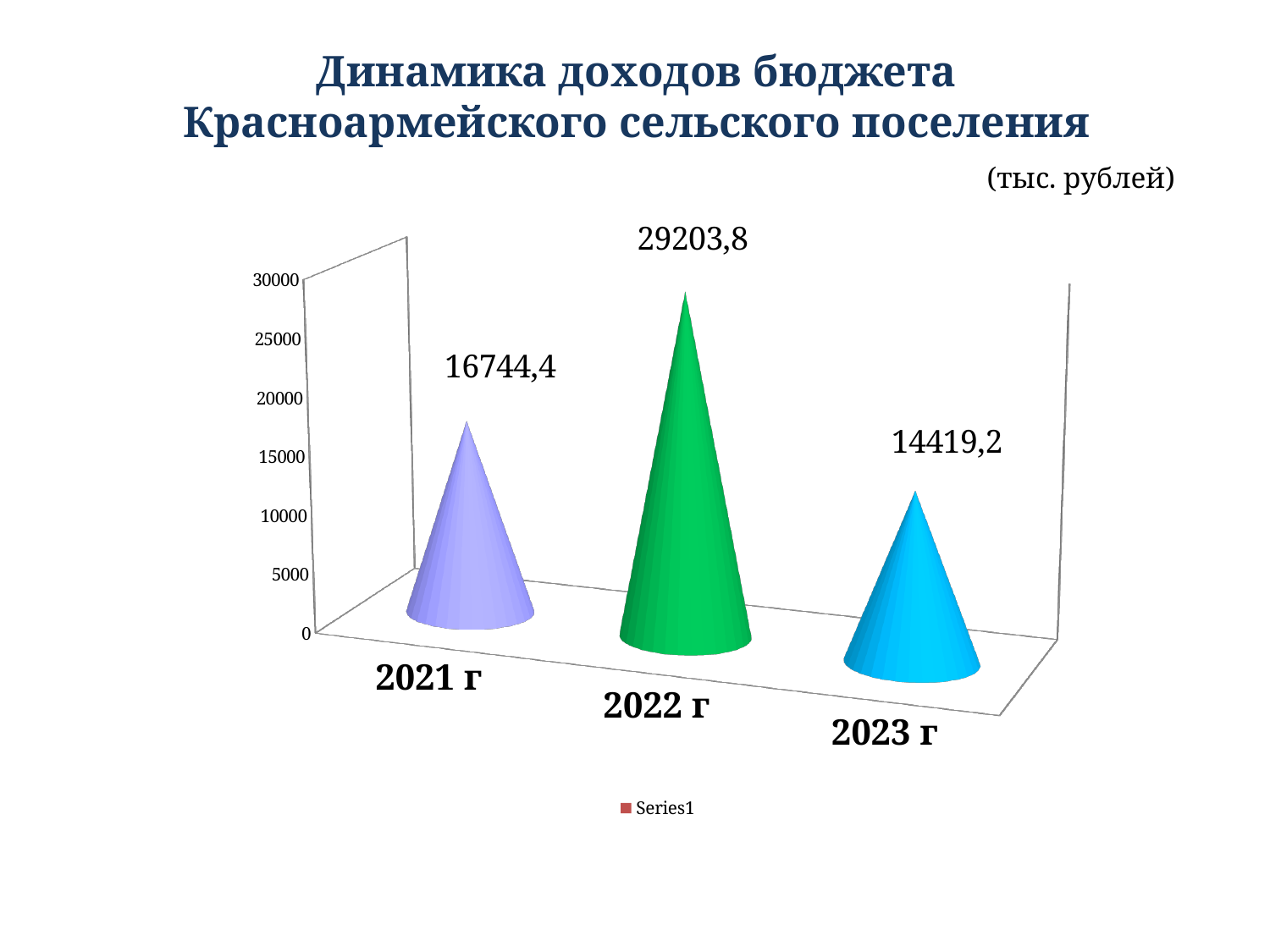
Which year has the highest value? 2022 г Which year has the lowest value? 2023 г What is the value for 2022 г? 29203,8 What unit is stated for the values on the slide? тыс. рублей How many series does the legend list? 1 How many years are shown on the x axis? 3 What is the difference between the values for 2022 г and 2021 г? 12459,4 Is the value for 2022 г greater or less than 25000? greater What is the difference between the values for 2021 г and 2023 г? 2325,2 Which is larger, the value for 2021 г or the value for 2023 г? 2021 г What is the value for 2023 г? 14419,2 What is the value for 2021 г? 16744,4